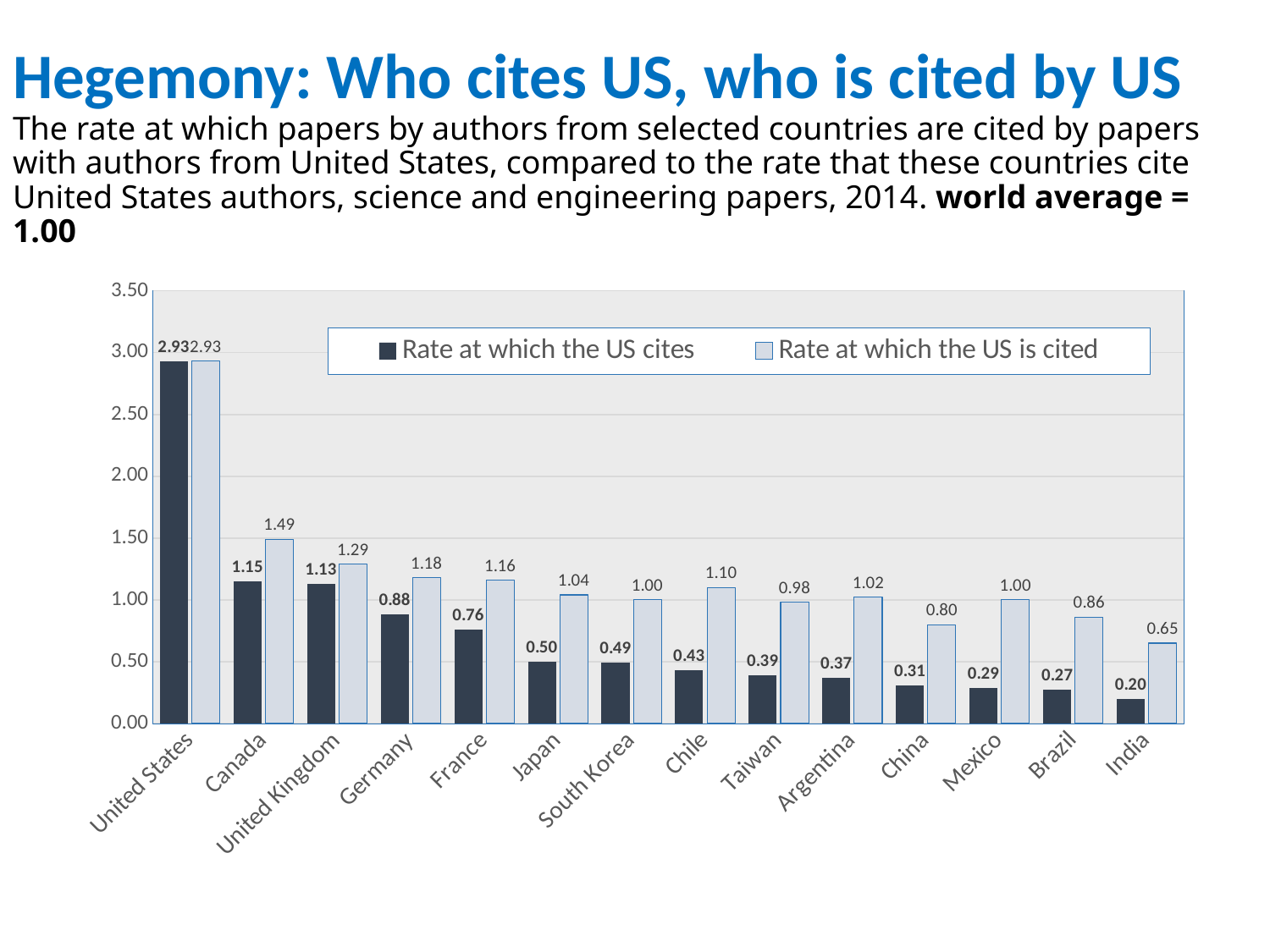
How many countries are shown on the x axis? 14 What kind of chart is shown on the slide? Bar chart Which country has the lowest 'Rate at which the US cites' value? India What is the 'Rate at which the US is cited' value for Germany? 1.18 How many series does the legend list? 2 Which country has the highest 'Rate at which the US is cited' value, excluding the United States? Canada Do the 'Rate at which the US cites' values rise or fall from left to right along the x axis? Fall What is the 'Rate at which the US cites' value for Canada? 1.15 What is the 'Rate at which the US cites' value for India? 0.20 For China, which is larger: the 'Rate at which the US cites' or the 'Rate at which the US is cited'? Rate at which the US is cited What is the difference between the 'Rate at which the US is cited' and the 'Rate at which the US cites' for Japan? 0.54 What is the 'Rate at which the US is cited' value for Brazil? 0.86